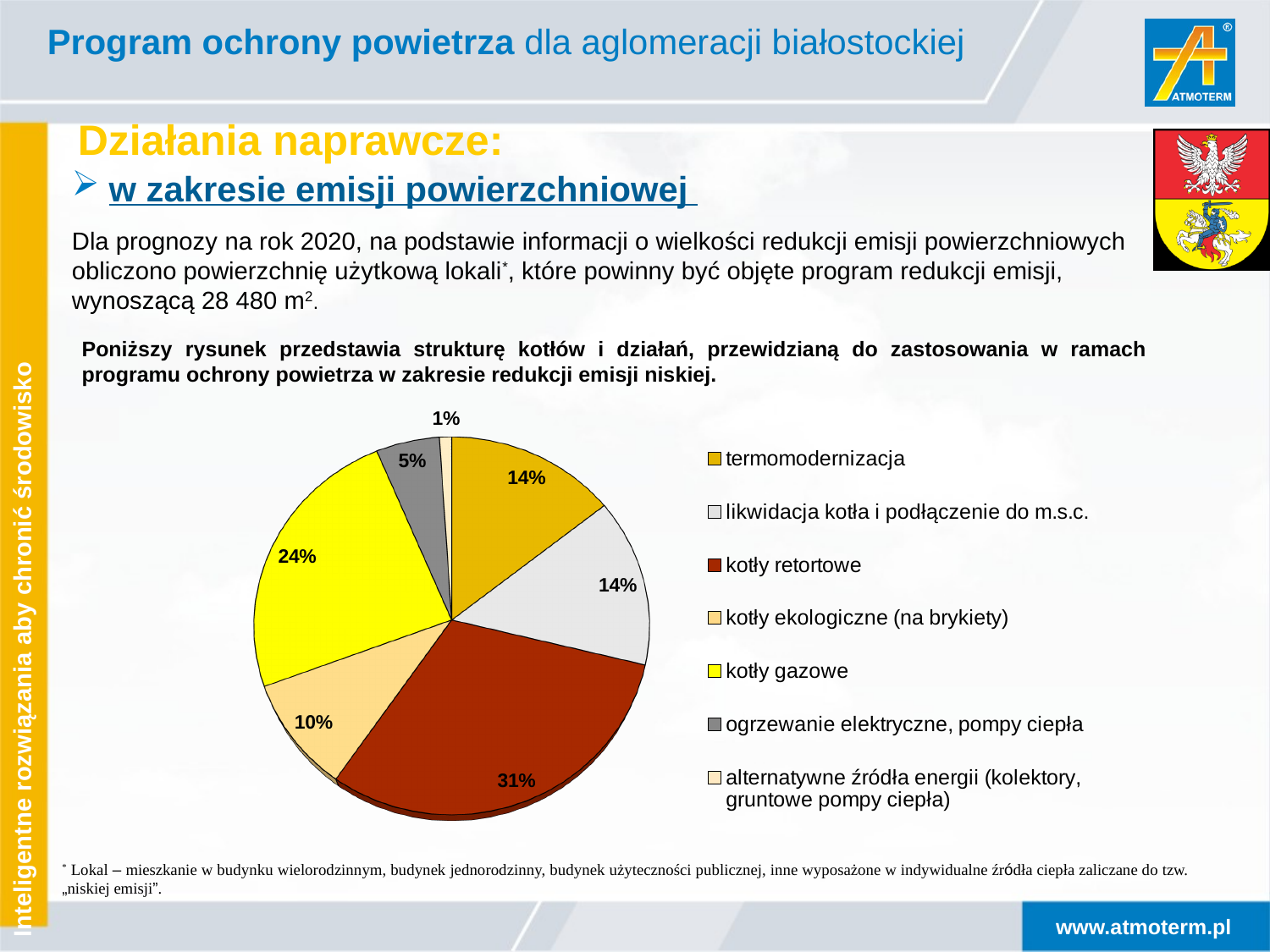
Which is larger, the slice for "kotły gazowe" or the slice for "termomodernizacja"? kotły gazowe How many categories does the legend of the pie chart list? 7 What is the difference in percentage points between "kotły retortowe" and "kotły gazowe"? 7 What is the value shown for "kotły ekologiczne (na brykiety)"? 10% What is the value shown for "ogrzewanie elektryczne, pompy ciepła"? 5% What type of chart is shown on the slide? pie chart What is the value shown for "alternatywne źródła energii (kolektory, gruntowe pompy ciepła)"? 1% What colour is the slice for "kotły gazowe"? yellow What share of the pie does "kotły retortowe" have? 31% What share of the pie does "kotły gazowe" have? 24% Which category has the largest slice of the pie? kotły retortowe Which category has the smallest slice of the pie? alternatywne źródła energii (kolektory, gruntowe pompy ciepła)